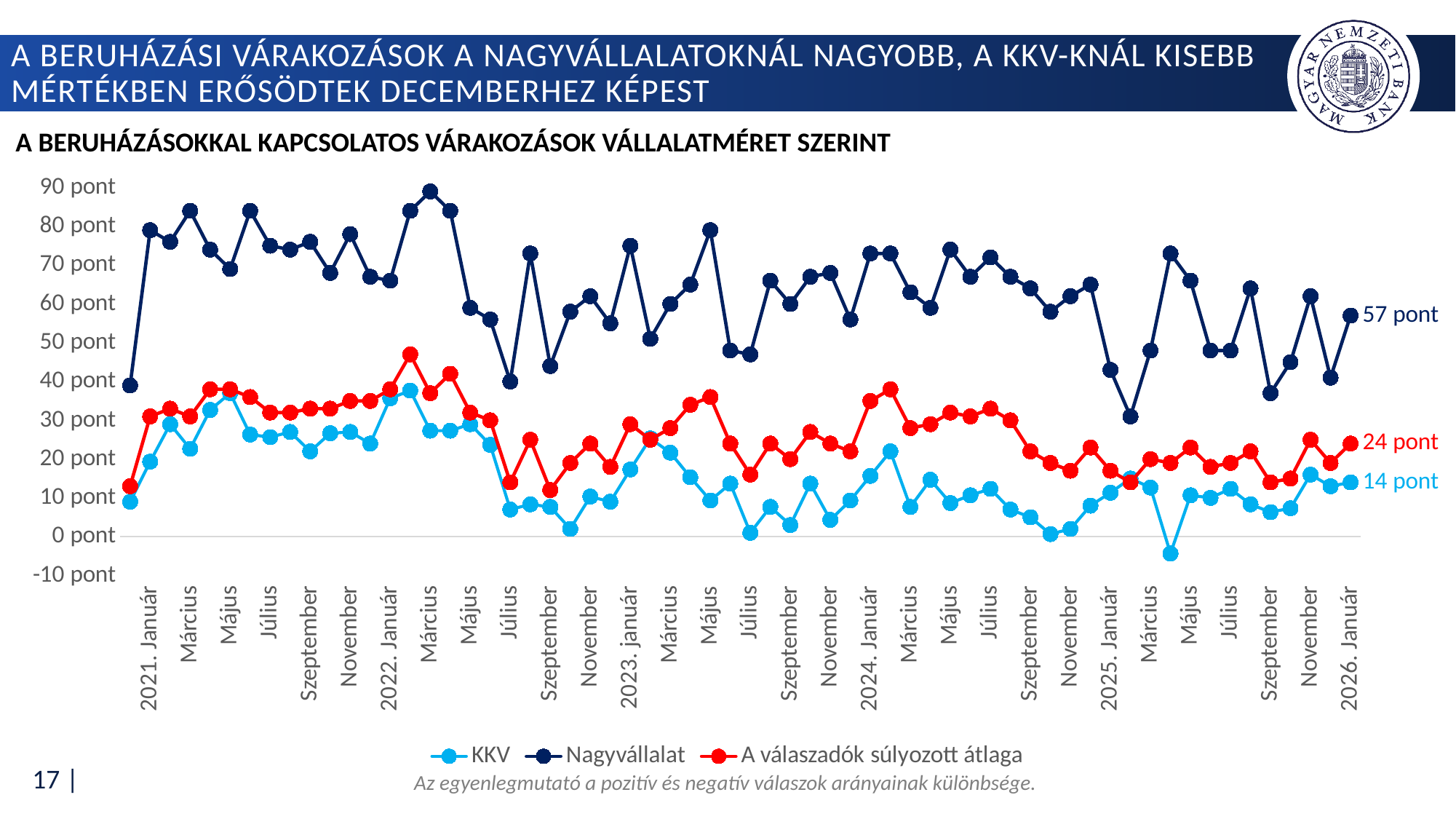
How many series does the legend list? 3 What is the value of the KKV series at 2026. Január? 14 pont Is the value for Nagyvállalat at 2022. Március greater or less than 80 pont? greater Is the value for Nagyvállalat at 2021. Január greater or less than 50 pont? greater At 2026. Január, which is larger: the Nagyvállalat value or the KKV value? Nagyvállalat Which series has the highest value at 2026. Január? Nagyvállalat What is the value of the Nagyvállalat series at 2026. Január? 57 pont At 2026. Január, what is the difference between the Nagyvállalat value and the KKV value? 43 pont What kind of chart is shown on the slide? line chart At 2026. Január, what is the difference between 'A válaszadók súlyozott átlaga' and the KKV value? 10 pont Which series has the lowest value at 2026. Január? KKV What is the value of 'A válaszadók súlyozott átlaga' at 2026. Január? 24 pont